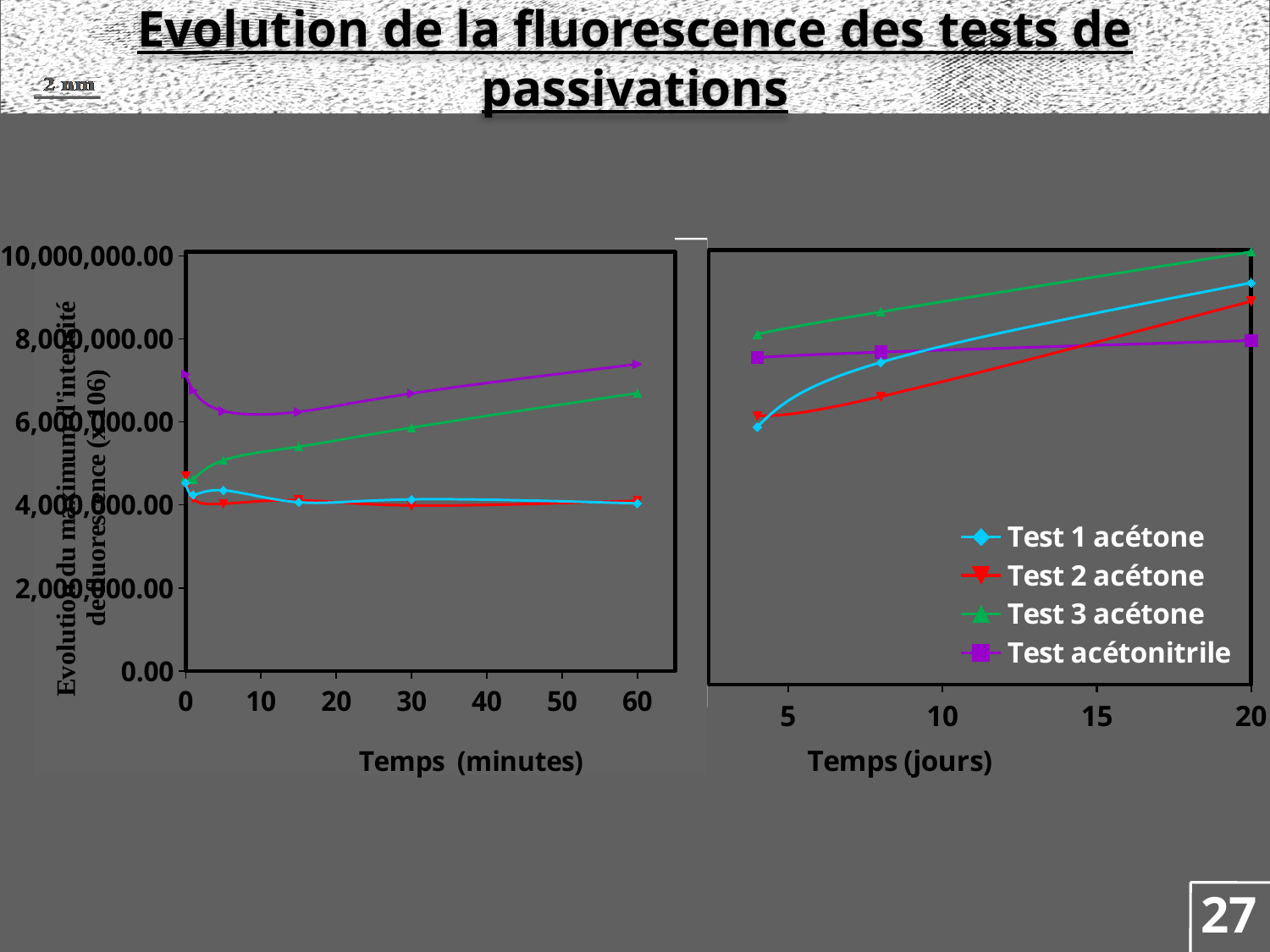
In the right chart (Temps (jours)), which series has the highest value at 20 days? Test 3 acétone In the left chart (Temps (minutes)), does Test 3 acétone rise or fall between 0 and 60 minutes? rise In the right chart (Temps (jours)), which series has the lowest value at 20 days? Test acétonitrile In the left chart (Temps (minutes)), which series has the highest value at 60 minutes? Test acétonitrile In the right chart (Temps (jours)), is the value of Test 1 acétone at 20 days greater or less than 8,000,000.00? greater In the left chart (Temps (minutes)), is the value of Test 3 acétone at 60 minutes greater or less than 6,000,000.00? greater In the right chart (Temps (jours)), which is larger at 20 days: Test 1 acétone or Test acétonitrile? Test 1 acétone What is the x-axis title of the right chart? Temps (jours) In the left chart (Temps (minutes)), which is larger at 30 minutes: Test 3 acétone or Test 1 acétone? Test 3 acétone What kind of chart is the left chart (Temps (minutes))? line chart In the right chart (Temps (jours)), does Test 2 acétone rise or fall from 5 to 20 days? rise How many series does the legend list? 4